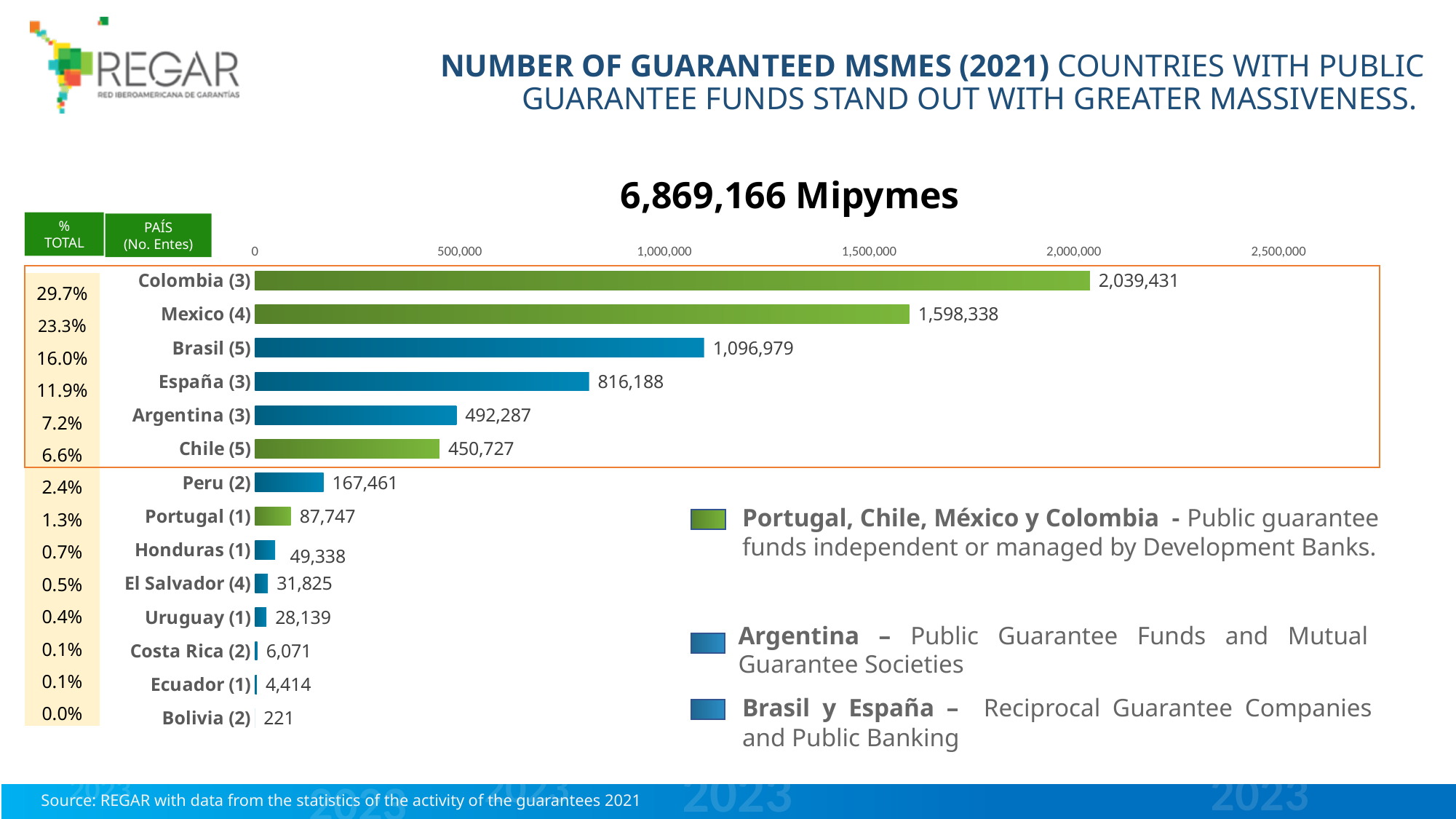
What is the difference between the values for Colombia (3) and Mexico (4)? 441,093 Which country has the highest number of guaranteed MSMEs? Colombia (3) Which country has the lowest number of guaranteed MSMEs? Bolivia (2) How many countries are listed in the chart? 14 What kind of chart is shown on the slide? bar chart What percentage of the total is shown for Mexico (4)? 23.3% What is the difference between the values for Argentina (3) and Chile (5)? 41,560 What is the value shown for Peru (2)? 167,461 How many guaranteed MSMEs are shown for Colombia (3)? 2,039,431 Which is larger, the value for España (3) or the value for Argentina (3)? España (3) What is the value shown for Brasil (5)? 1,096,979 Is the value for Brasil (5) greater or less than 1,000,000? greater